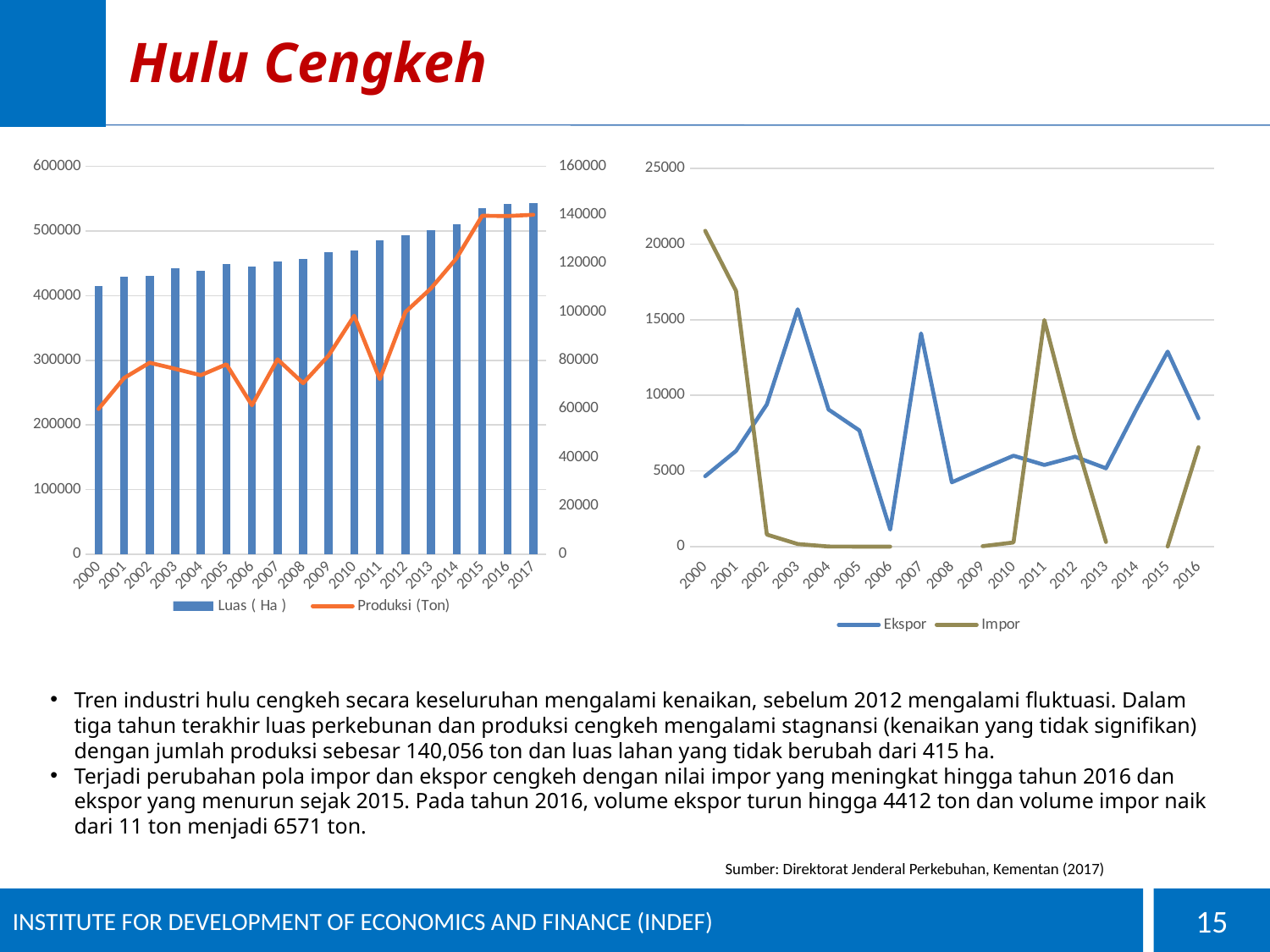
In the left chart, which year has the lowest Luas ( Ha ) bar? 2000 In the right chart, which year has the highest Impor value? 2000 In the left chart, is the Luas ( Ha ) value for 2017 greater or less than 500000? greater In the left chart, how many years are shown on the x axis? 18 In the left chart, what are the two series named in the legend? Luas ( Ha ) and Produksi (Ton) In the left chart, how many series does the legend list? 2 In the left chart, is the Produksi (Ton) value for 2011 greater or less than 80000? less In the right chart, is the Ekspor value for 2006 greater or less than 5000? less In the right chart, how many years are shown on the x axis? 17 In the right chart, which is larger in 2011, Ekspor or Impor? Impor What kind of chart is the right chart (Ekspor and Impor)? line chart In the left chart, do the Luas ( Ha ) bars generally rise or fall from 2000 to 2017? rise